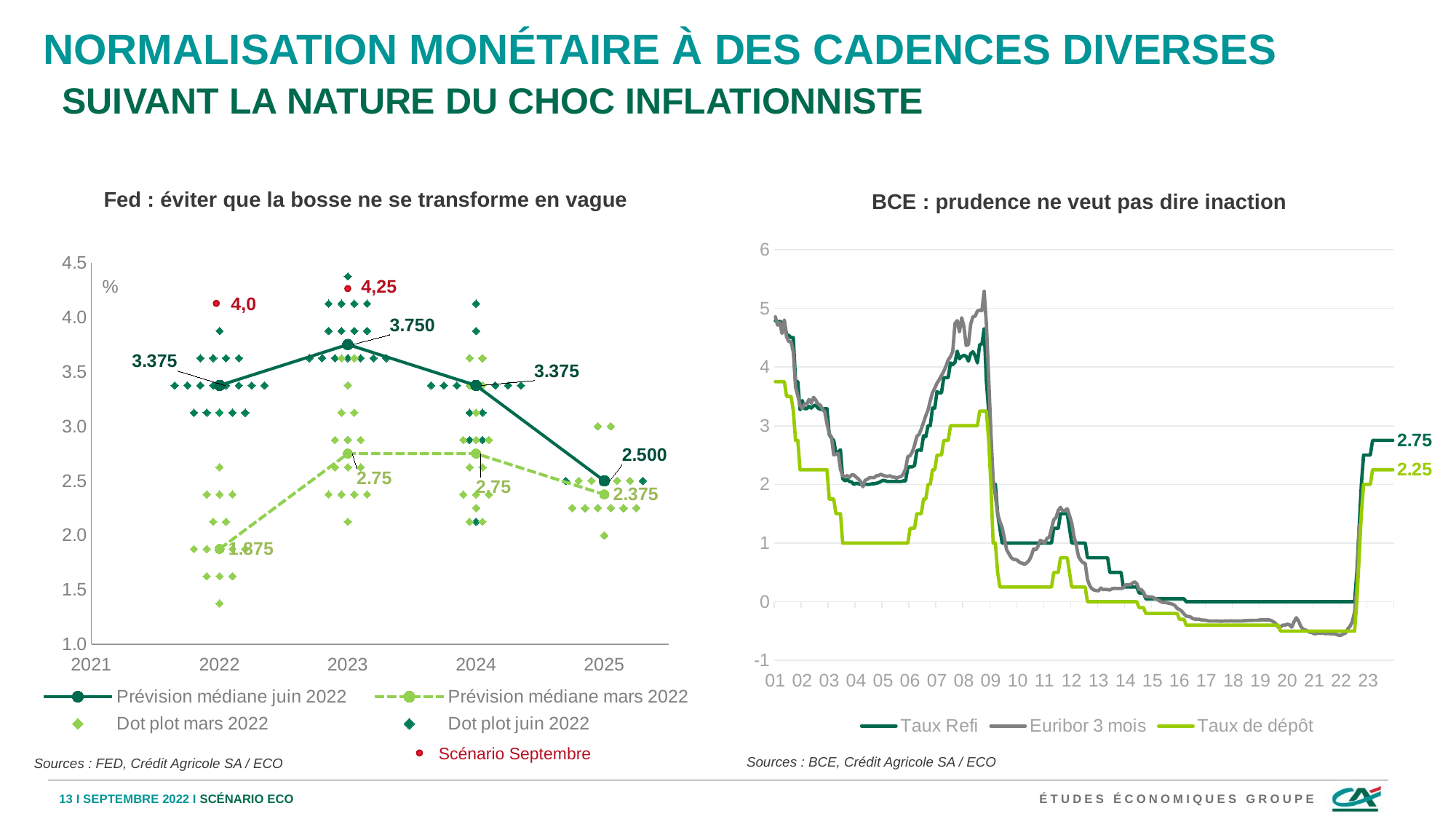
On the Fed chart, what is the value of the Prévision médiane mars 2022 for 2022? 1.875 On the Fed chart, what is the value of the Prévision médiane juin 2022 for 2023? 3.750 On the Fed chart, what is the difference between the Prévision médiane juin 2022 and the Prévision médiane mars 2022 for 2022? 1.5 On the BCE chart, what is the final labelled value of the Taux de dépôt? 2.25 On the Fed chart, how many series does the legend list? 5 On the BCE chart, is the peak value of Euribor 3 mois around 2008 greater or less than 5? greater On the Fed chart, for 2024, which is larger: the Prévision médiane juin 2022 or the Prévision médiane mars 2022? Prévision médiane juin 2022 On the Fed chart, in which year is the Prévision médiane juin 2022 lowest? 2025 On the Fed chart, what is the Scénario Septembre value for 2023? 4,25 What kind of chart is the BCE chart? line chart On the Fed chart, in which year is the Prévision médiane juin 2022 highest? 2023 On the BCE chart, what is the final labelled value of the Taux Refi? 2.75